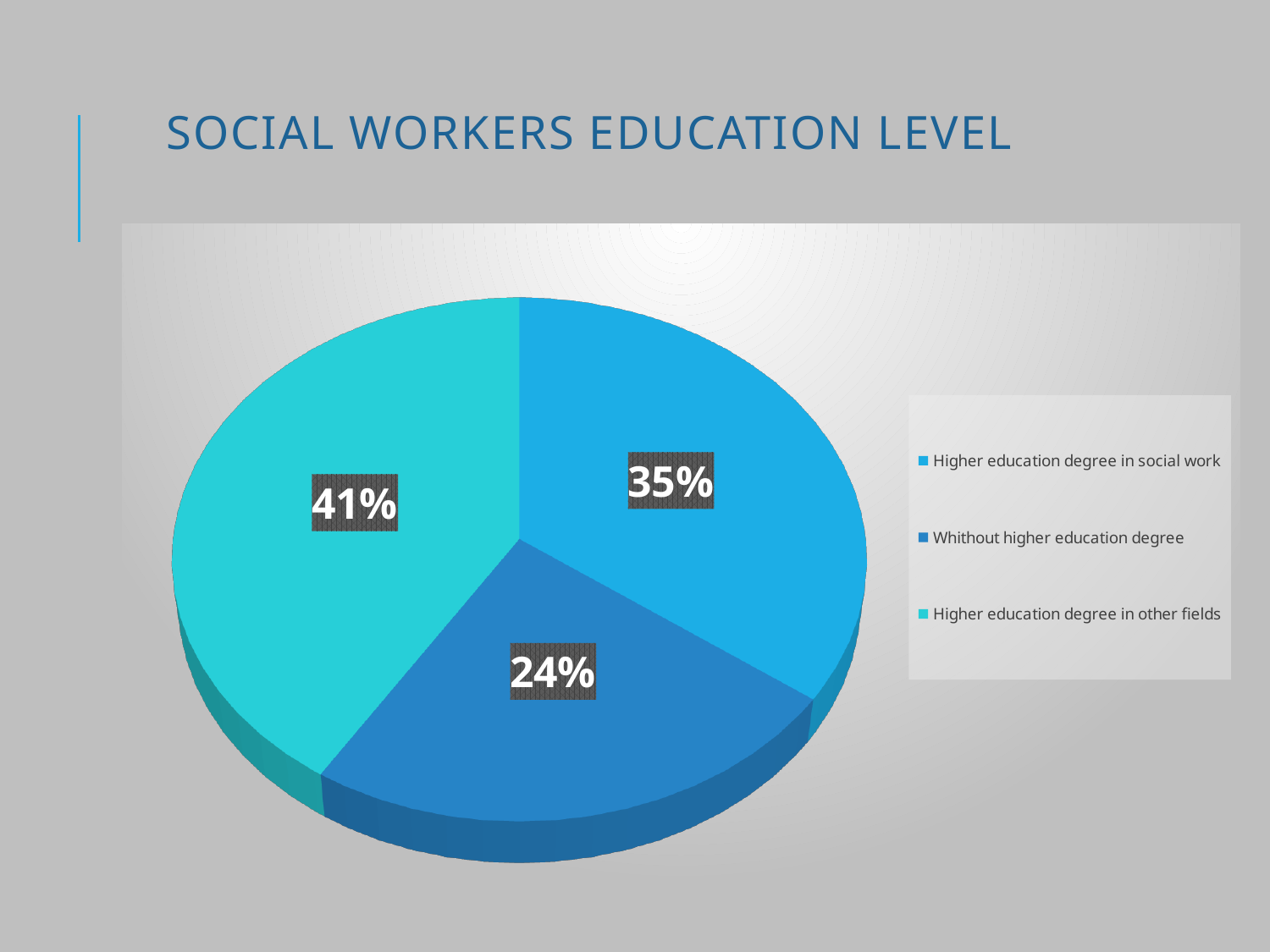
What share of social workers are without a higher education degree? 24% What share of social workers have a higher education degree in other fields? 41% How many slices does the pie chart have? 3 What is the difference in percentage points between the share with a higher education degree in other fields and the share with a higher education degree in social work? 6 What is the difference in percentage points between the share with a higher education degree in social work and the share without a higher education degree? 11 Which category has the smallest share of the pie? Whithout higher education degree What kind of chart is shown on the slide? Pie chart Which category has the largest share of the pie? Higher education degree in other fields What is the title of the slide containing the chart? SOCIAL WORKERS EDUCATION LEVEL What share of social workers have a higher education degree in social work? 35% Which is larger: the share with a higher education degree in social work or the share without a higher education degree? Higher education degree in social work How many entries does the legend list? 3